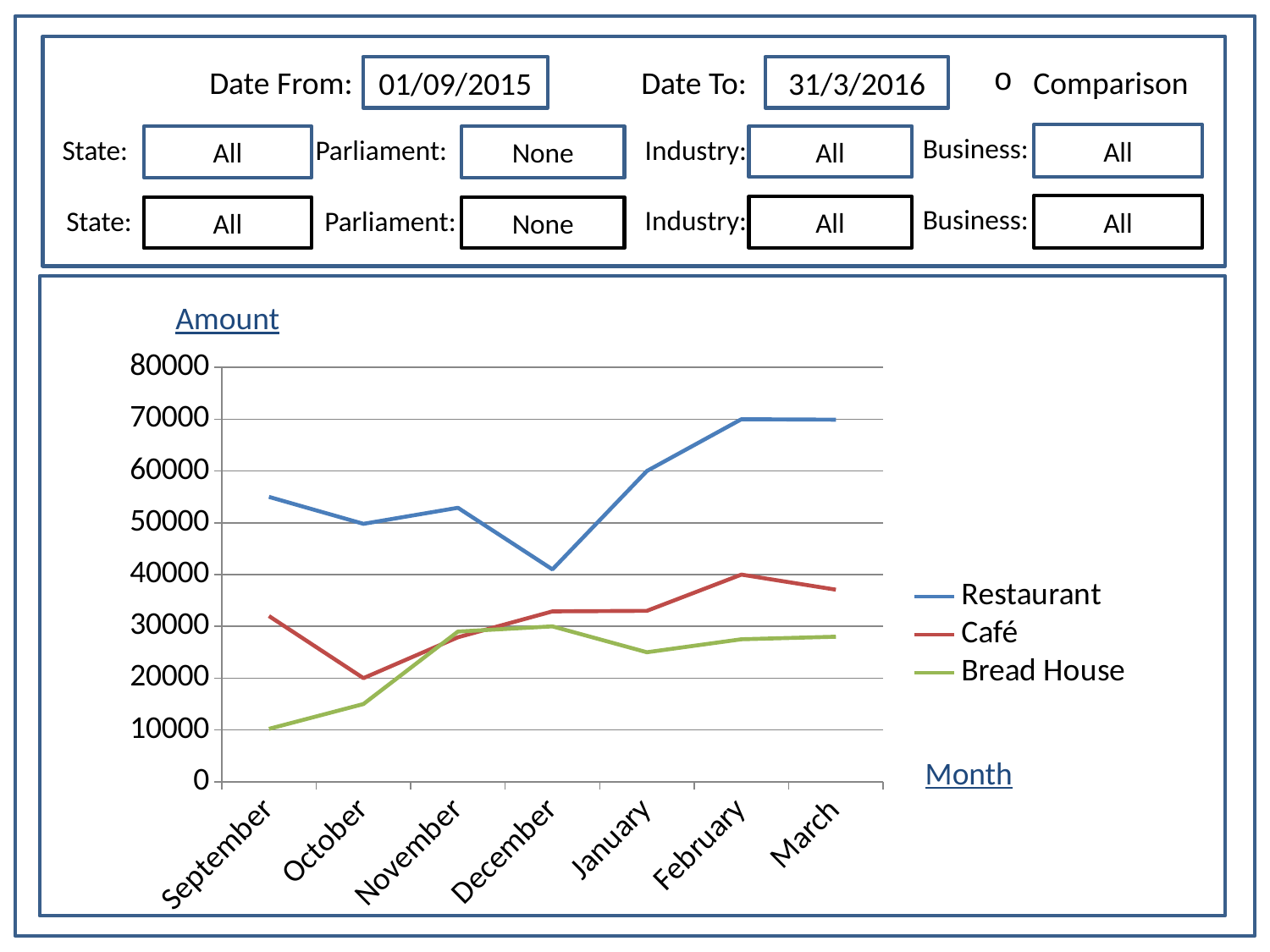
What is the Café value for February? 40000 Is the Bread House value for September greater or less than 20000? less What is the Bread House value for December? 30000 What kind of chart is shown on the slide? line chart In which month is the Café value highest? February What is the label on the vertical axis of the chart? Amount How many months are plotted along the x axis? 7 In which month is the Restaurant value lowest? December Which is larger in September, the Restaurant value or the Café value? Restaurant How many series does the legend list? 3 Is the Restaurant value for December greater or less than 50000? less